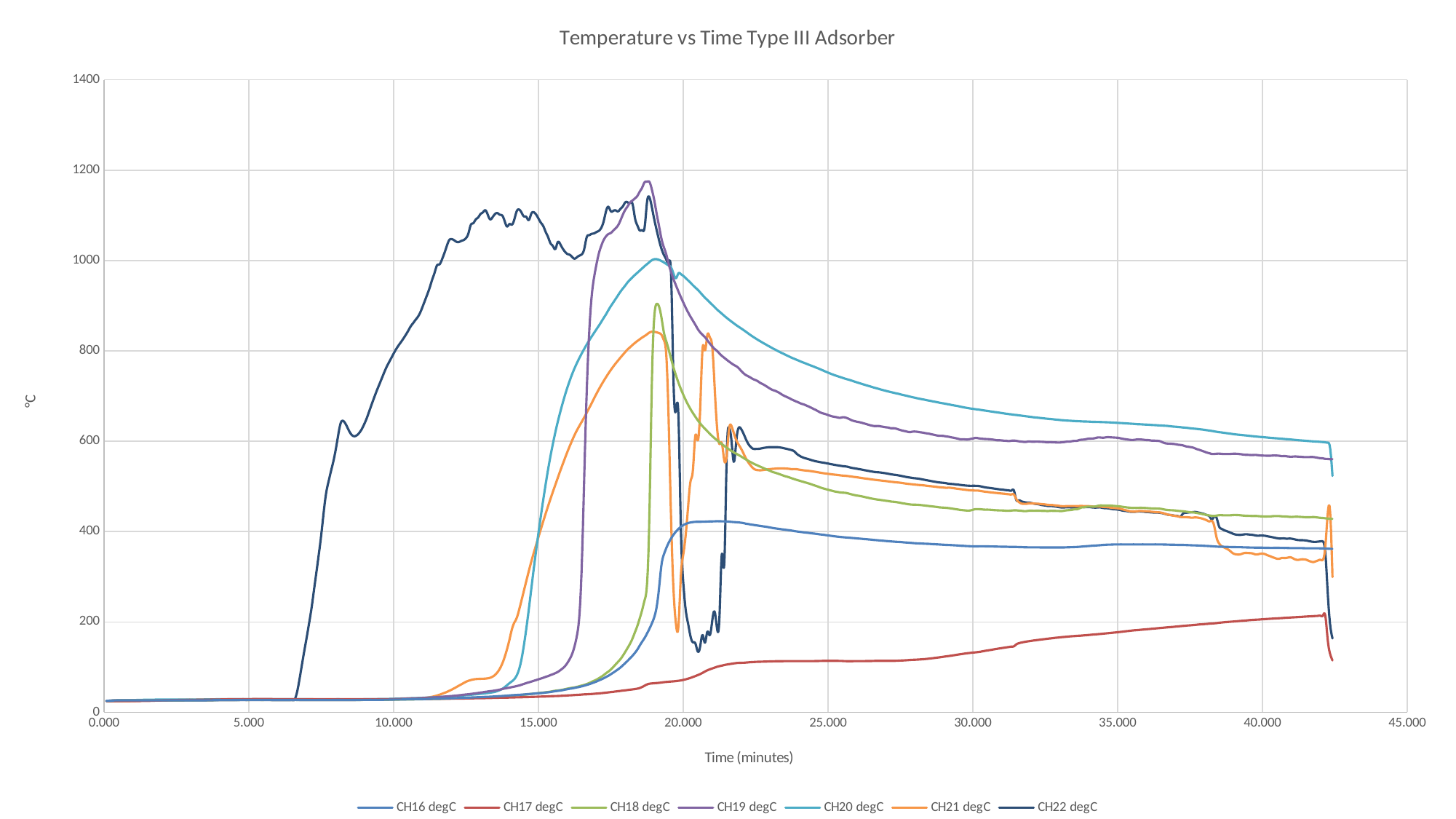
Does CH17 degC generally rise or fall as time increases? rise Is the peak value of CH16 degC greater or less than 600? less At 30.000 minutes, which is larger: CH20 degC or CH16 degC? CH20 degC Is the value of CH22 degC at 10.000 minutes greater or less than 600? greater How many series does the legend list? 7 After 20.000 minutes, does CH20 degC rise or fall as time increases? fall What is the title of the chart? Temperature vs Time Type III Adsorber What kind of chart is shown on the slide? line chart Is the value of CH17 degC at 40.000 minutes greater or less than 400? less Which series stays lowest across the whole time range? CH17 degC What is the label of the x axis? Time (minutes)